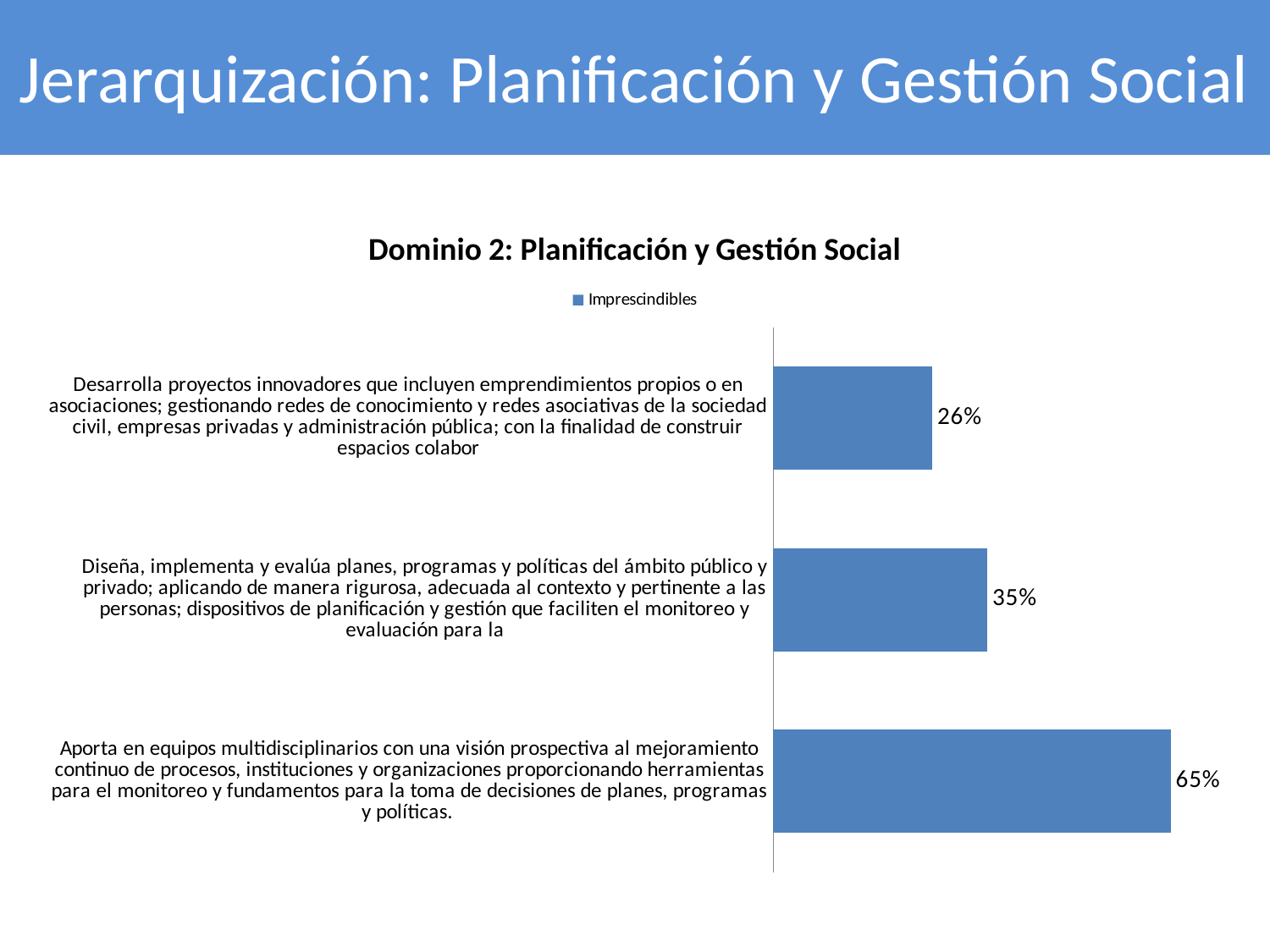
How many series does the legend list? 1 What is the value for the category beginning "Aporta en equipos multidisciplinarios"? 65% Which is larger: the value for the "Desarrolla proyectos innovadores" category or the "Diseña, implementa y evalúa planes" category? Diseña, implementa y evalúa planes What is the difference between the value for the "Aporta en equipos multidisciplinarios" category and the "Diseña, implementa y evalúa planes" category? 30% What is the difference between the value for the "Diseña, implementa y evalúa planes" category and the "Desarrolla proyectos innovadores" category? 9% How many categories are shown in the chart? 3 What is the title of the chart? Dominio 2: Planificación y Gestión Social What is the value for the category beginning "Desarrolla proyectos innovadores"? 26% What kind of chart is shown on the slide? Bar chart What is the value for the category beginning "Diseña, implementa y evalúa planes"? 35%